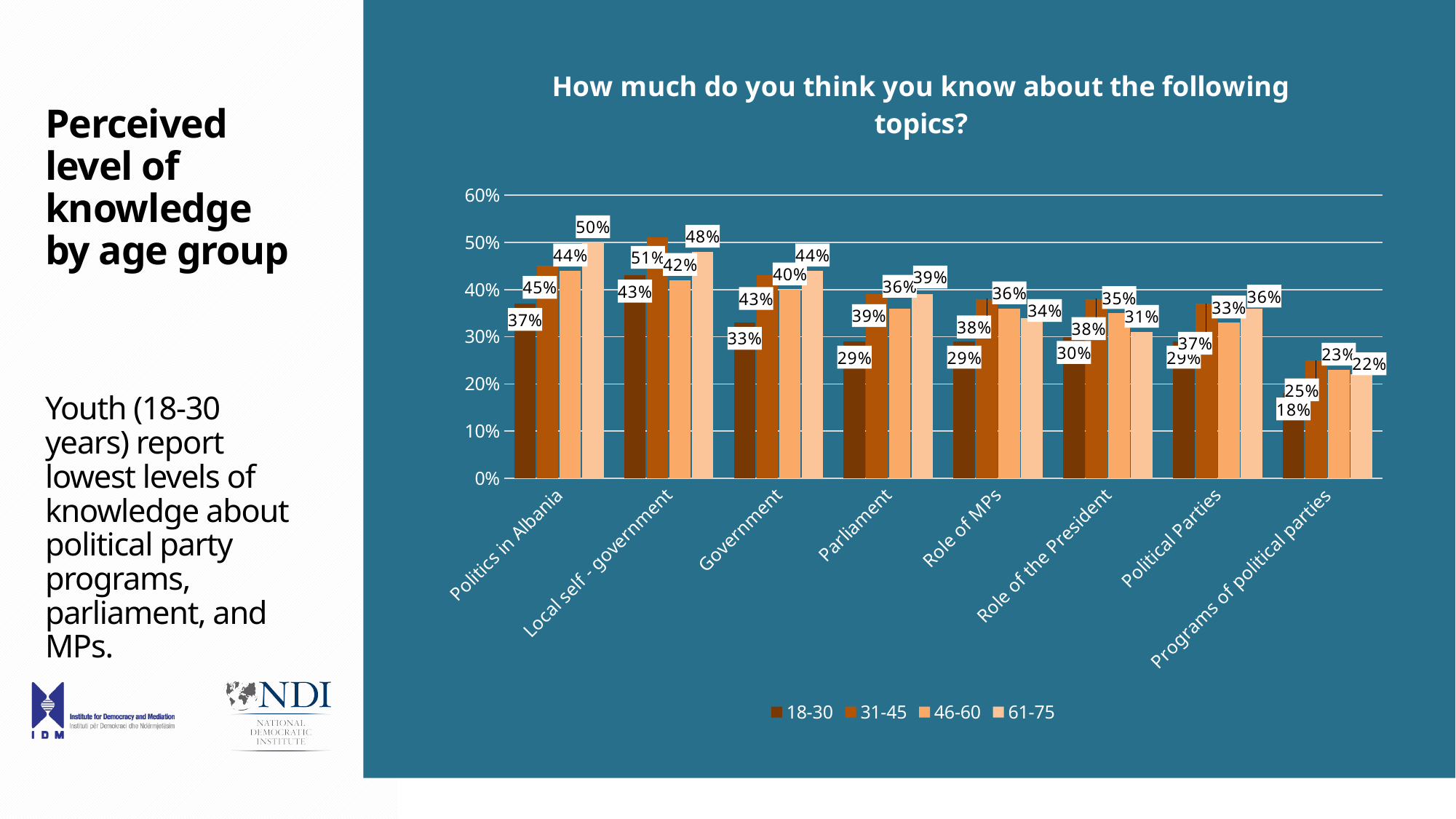
What is the value for the 61-75 age group for Local self - government? 48% What is the value for the 31-45 age group for Programs of political parties? 25% What is the value for the 18-30 age group for Politics in Albania? 37% How many topics are shown on the x axis? 8 What kind of chart is shown on the slide? Bar chart How many age groups does the legend list? 4 What is the value for the 46-60 age group for Role of the President? 35% What is the difference between the 61-75 and 18-30 values for Politics in Albania? 13% Which topic has the highest value for the 31-45 age group? Local self - government Which topic has the lowest value for the 18-30 age group? Programs of political parties What is the title of the chart? How much do you think you know about the following topics? For Government, which age group has the larger value, 31-45 or 46-60? 31-45